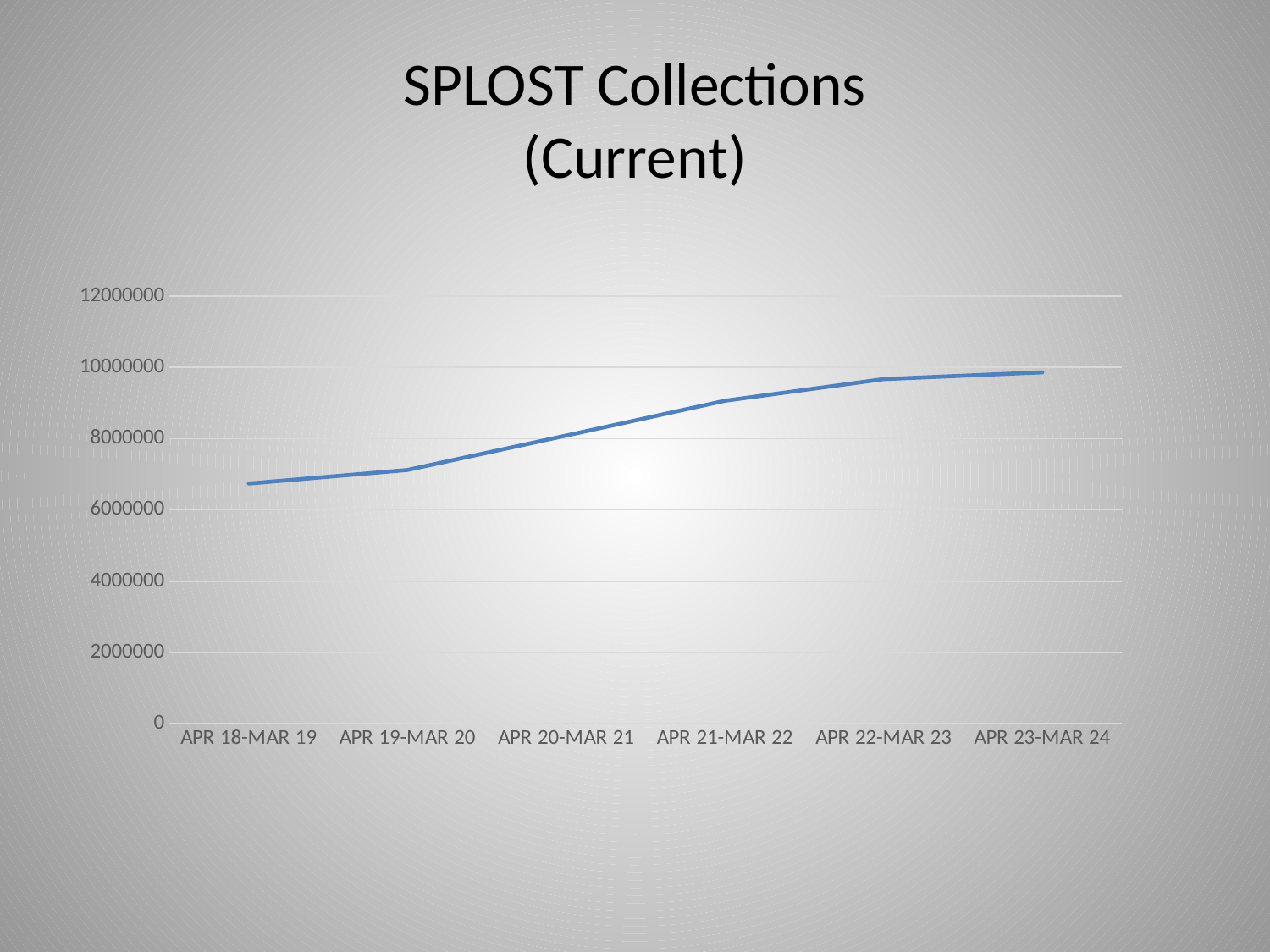
Is the value for APR 23-MAR 24 greater or less than 10000000? less Is the value for APR 18-MAR 19 greater or less than 8000000? less What is the title of the chart? SPLOST Collections (Current) Do SPLOST collections rise or fall from APR 18-MAR 19 to APR 23-MAR 24? rise How many periods are plotted along the x axis? 6 Which period has the lowest SPLOST collections? APR 18-MAR 19 Which period has the highest SPLOST collections? APR 23-MAR 24 Is the value for APR 20-MAR 21 greater or less than 6000000? greater What kind of chart is shown on the slide? line chart Which period has higher collections, APR 19-MAR 20 or APR 21-MAR 22? APR 21-MAR 22 What is the highest value shown on the y axis? 12000000